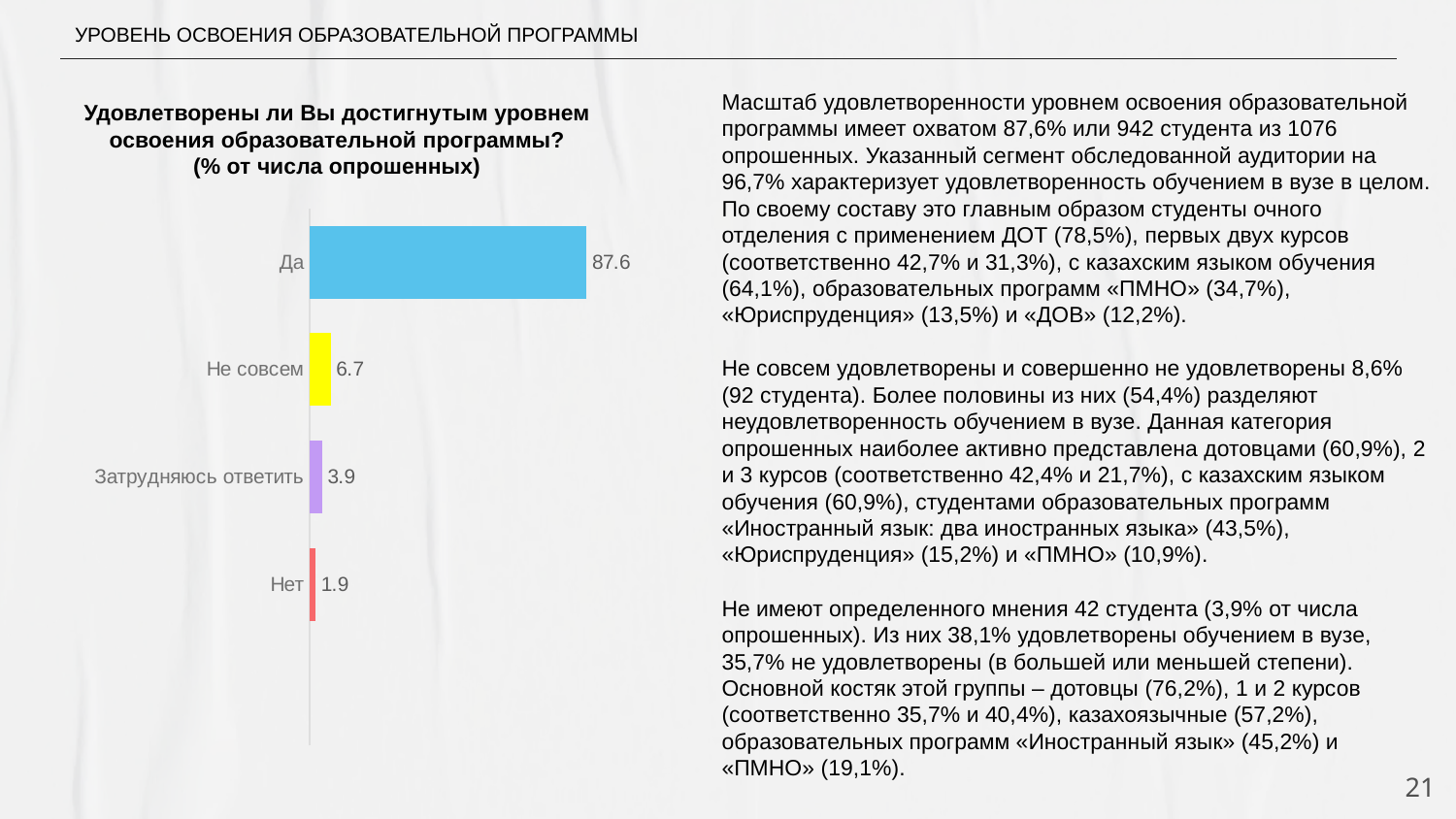
Which category has the lowest value? Нет What type of chart is shown on the slide? Bar chart Which category has the highest value? Да How many categories are shown in the chart? 4 What is the difference between the values for "Затрудняюсь ответить" and "Нет"? 2.0 What colour is the bar for "Да"? Blue What is the difference between the values for "Да" and "Не совсем"? 80.9 Which is larger, the value for "Не совсем" or the value for "Затрудняюсь ответить"? Не совсем What value is shown for the category "Не совсем"? 6.7 What value is shown for the category "Нет"? 1.9 What value is shown for the category "Да"? 87.6 What value is shown for the category "Затрудняюсь ответить"? 3.9